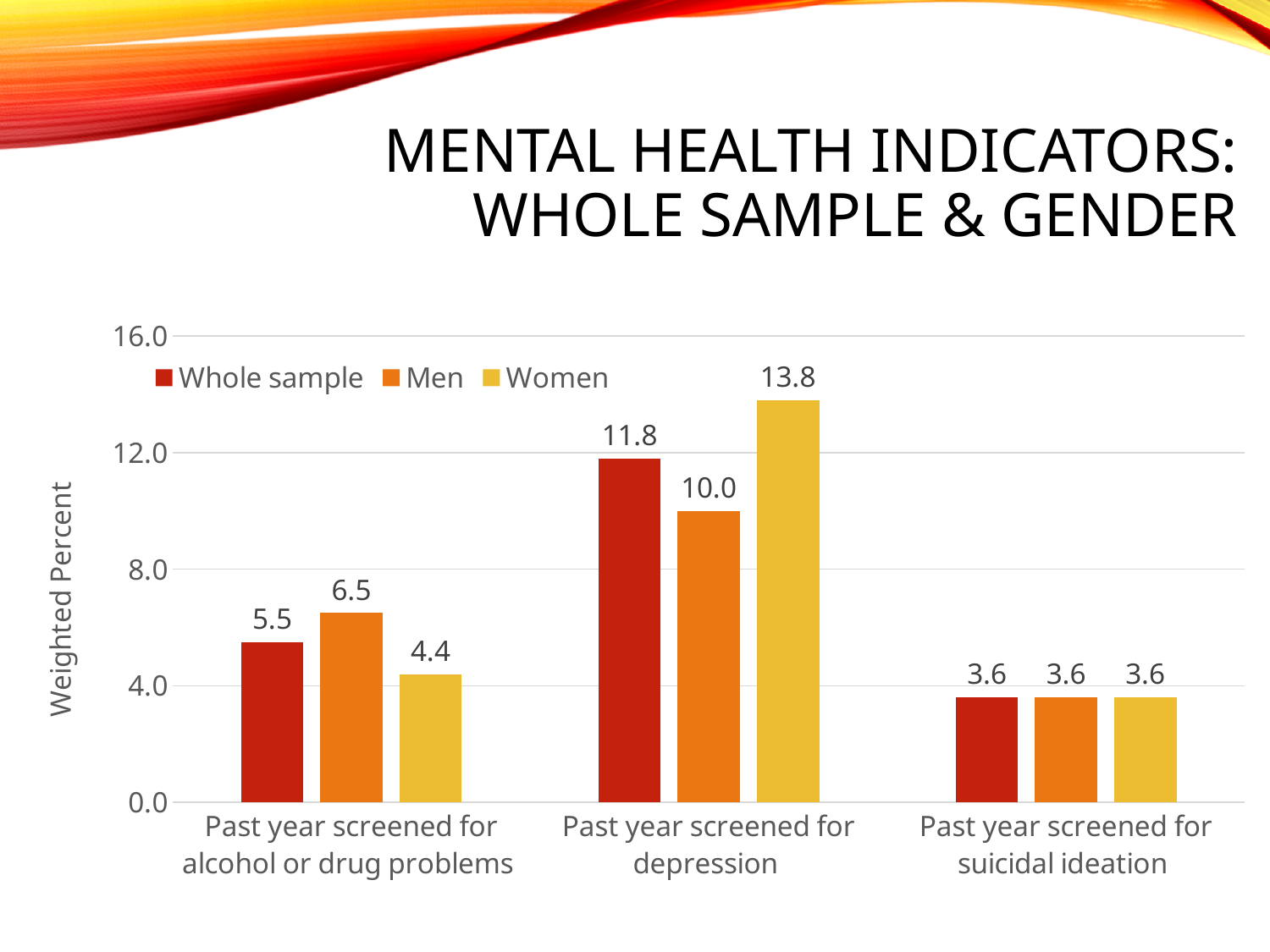
How many categories are shown on the x axis? 3 Which category has the lowest value for Women? Past year screened for suicidal ideation What is the value for the Whole sample for past year screened for alcohol or drug problems? 5.5 Which category has the highest value for Men? Past year screened for depression What is the value for Women for past year screened for depression? 13.8 How many series does the legend list? 3 What kind of chart is shown on the slide? Bar chart Is the Whole sample value for past year screened for depression greater or less than 8.0? greater What is the difference between the Men and Women values for past year screened for alcohol or drug problems? 2.1 What is the difference between the Women and Men values for past year screened for depression? 3.8 What is the value for Men for past year screened for suicidal ideation? 3.6 For past year screened for alcohol or drug problems, which is larger: the value for Men or the value for Women? Men